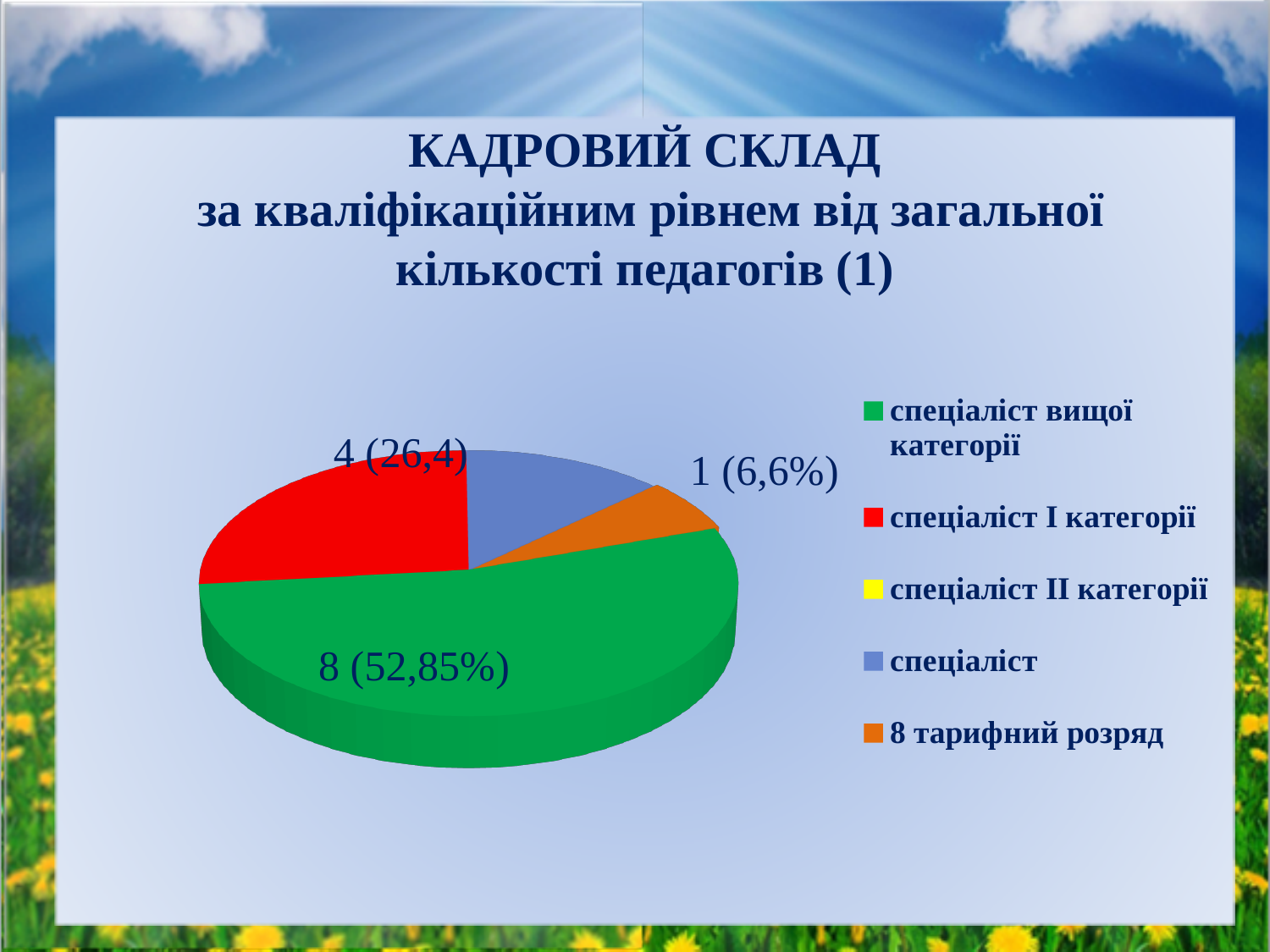
What is the data label shown on the slice for спеціаліст І категорії? 4 (26,4) Which slice is larger: спеціаліст вищої категорії or спеціаліст І категорії? спеціаліст вищої категорії How many entries does the legend list? 5 What is the data label shown on the slice for спеціаліст вищої категорії? 8 (52,85%) What is the data label shown for the 8 тарифний розряд slice? 1 (6,6%) Which legend entry is shown in green? спеціаліст вищої категорії Which category has the largest slice of the pie? спеціаліст вищої категорії What colour is the slice for спеціаліст І категорії? red What kind of chart is shown on the slide? pie chart Which slice is larger: спеціаліст І категорії or 8 тарифний розряд? спеціаліст І категорії What share of the pie does спеціаліст вищої категорії take? 52,85%